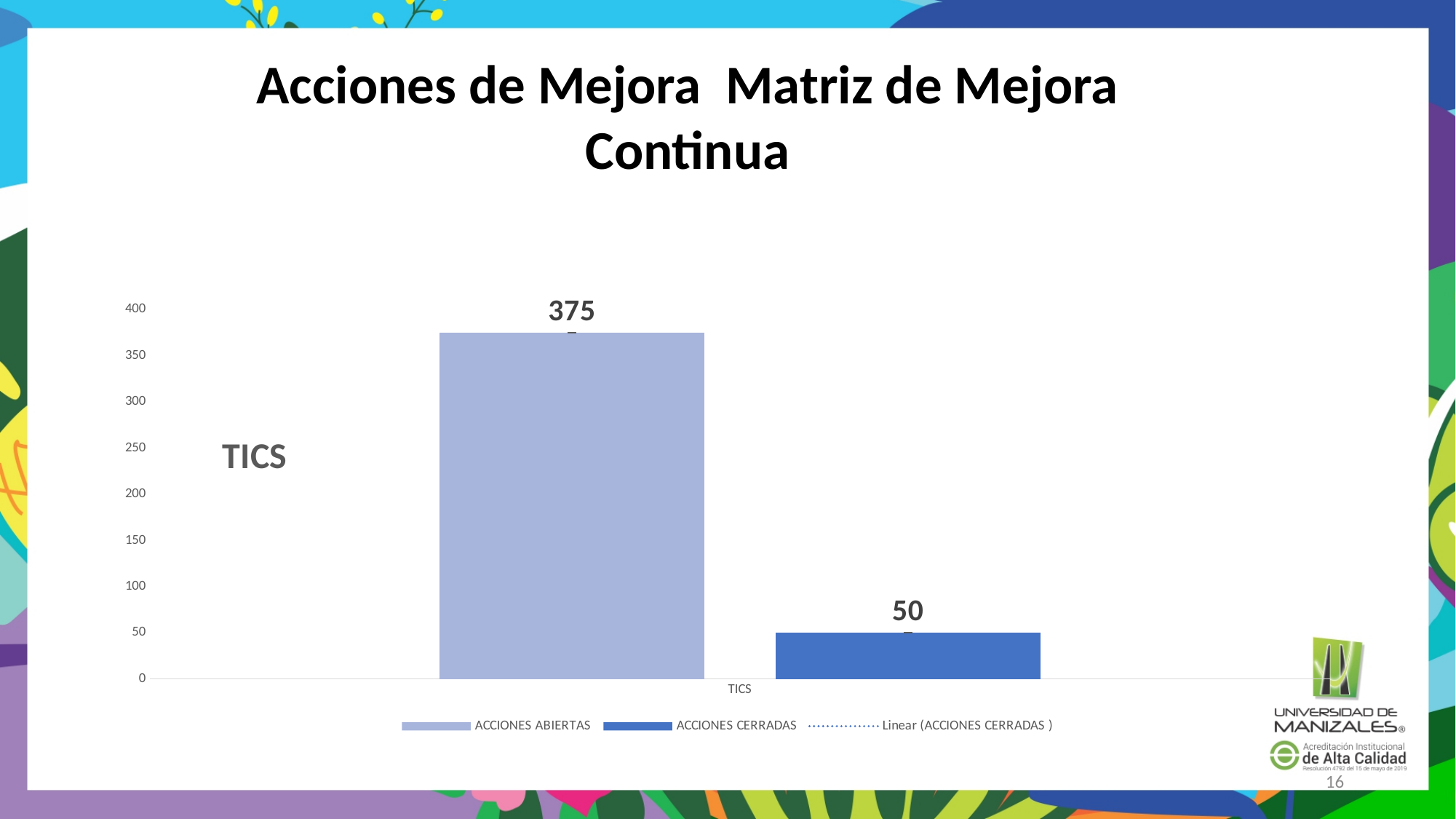
How many entries does the legend list? 3 Is the value for ACCIONES CERRADAS greater or less than 100? less What is the highest value shown on the y axis? 400 What is the title of the slide? Acciones de Mejora Matriz de Mejora Continua What is the name of the category on the x axis? TICS Is the value for ACCIONES ABIERTAS greater or less than 300? greater What is the value for ACCIONES CERRADAS in the TICS category? 50 How many categories are shown on the x axis? 1 What kind of chart is shown on the slide? bar chart What is the value for ACCIONES ABIERTAS in the TICS category? 375 What is the difference between ACCIONES ABIERTAS and ACCIONES CERRADAS? 325 Which series has the higher value, ACCIONES ABIERTAS or ACCIONES CERRADAS? ACCIONES ABIERTAS